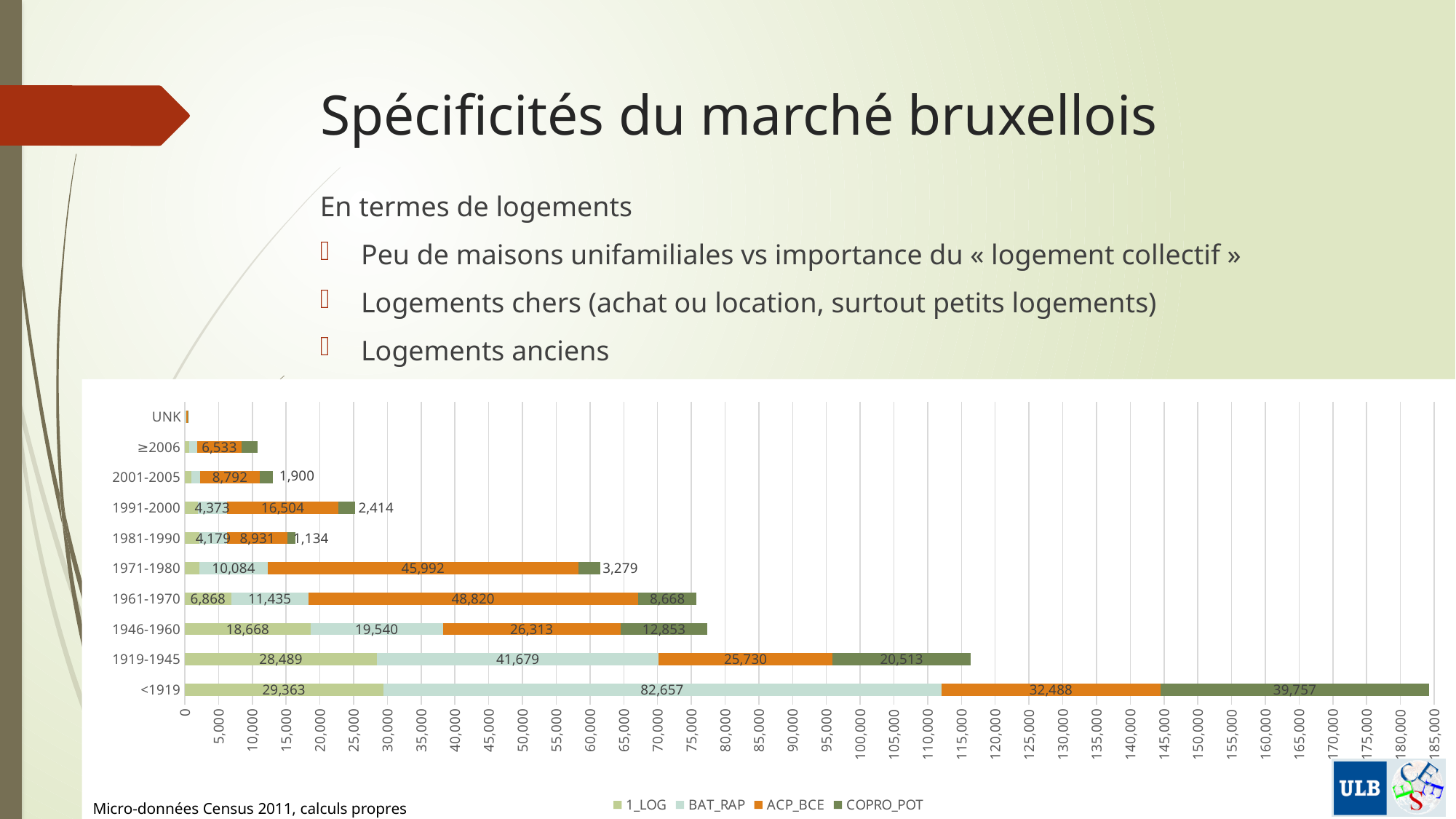
What type of chart is shown on the slide? stacked bar chart Which category has the longest total bar? <1919 What is the difference between the ACP_BCE values for 1961-1970 and 1971-1980? 2,828 What is the COPRO_POT value for the 1919-1945 category? 20,513 What is the total of the stacked bar for the 1946-1960 category? 77,374 What is the ACP_BCE value for the 1961-1970 category? 48,820 How many construction-period categories are shown on the vertical axis? 10 Is the total bar for the <1919 category greater or less than 180,000? greater Which category has the shortest total bar? UNK How many series does the legend list? 4 Which is larger, the 1_LOG value for <1919 or the 1_LOG value for 1919-1945? <1919 What is the BAT_RAP value for the <1919 category? 82,657